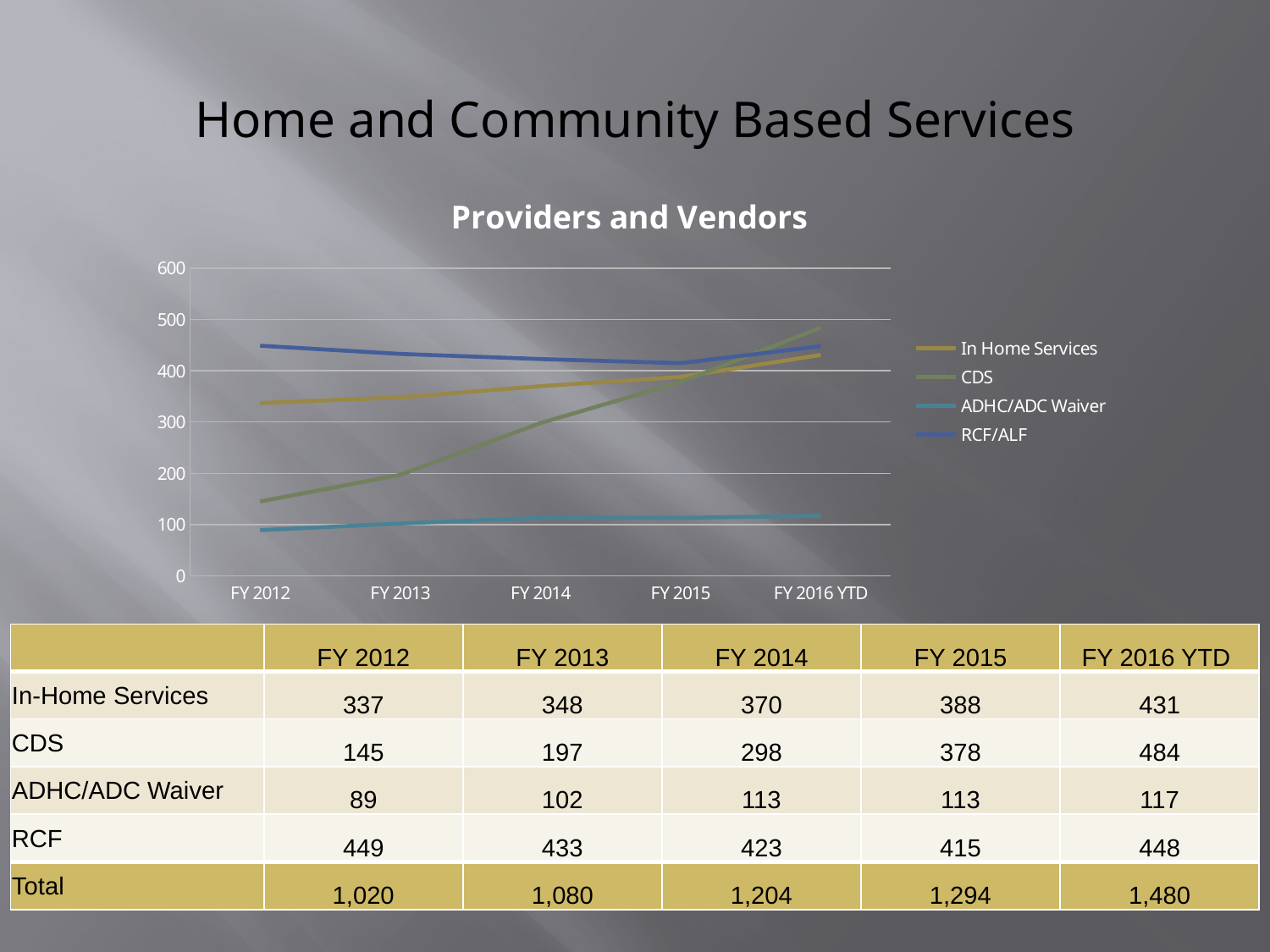
Does the CDS line rise or fall from FY 2012 to FY 2016 YTD? rise How many fiscal year points are plotted along the x axis of the 'Providers and Vendors' chart? 5 How many series does the legend of the 'Providers and Vendors' chart list? 4 What type of chart is shown under the title 'Providers and Vendors'? line chart What is the total of all four series in FY 2015? 1,294 Which series has the highest value in FY 2016 YTD? CDS What is the difference between the CDS values in FY 2016 YTD and FY 2012? 339 In FY 2014, which is larger: In-Home Services or CDS? In-Home Services Is the value for RCF/ALF in FY 2015 greater or less than 400? greater What is the value for CDS in FY 2016 YTD? 484 What is the value for In-Home Services in FY 2012? 337 Which series has the lowest value in FY 2012? ADHC/ADC Waiver